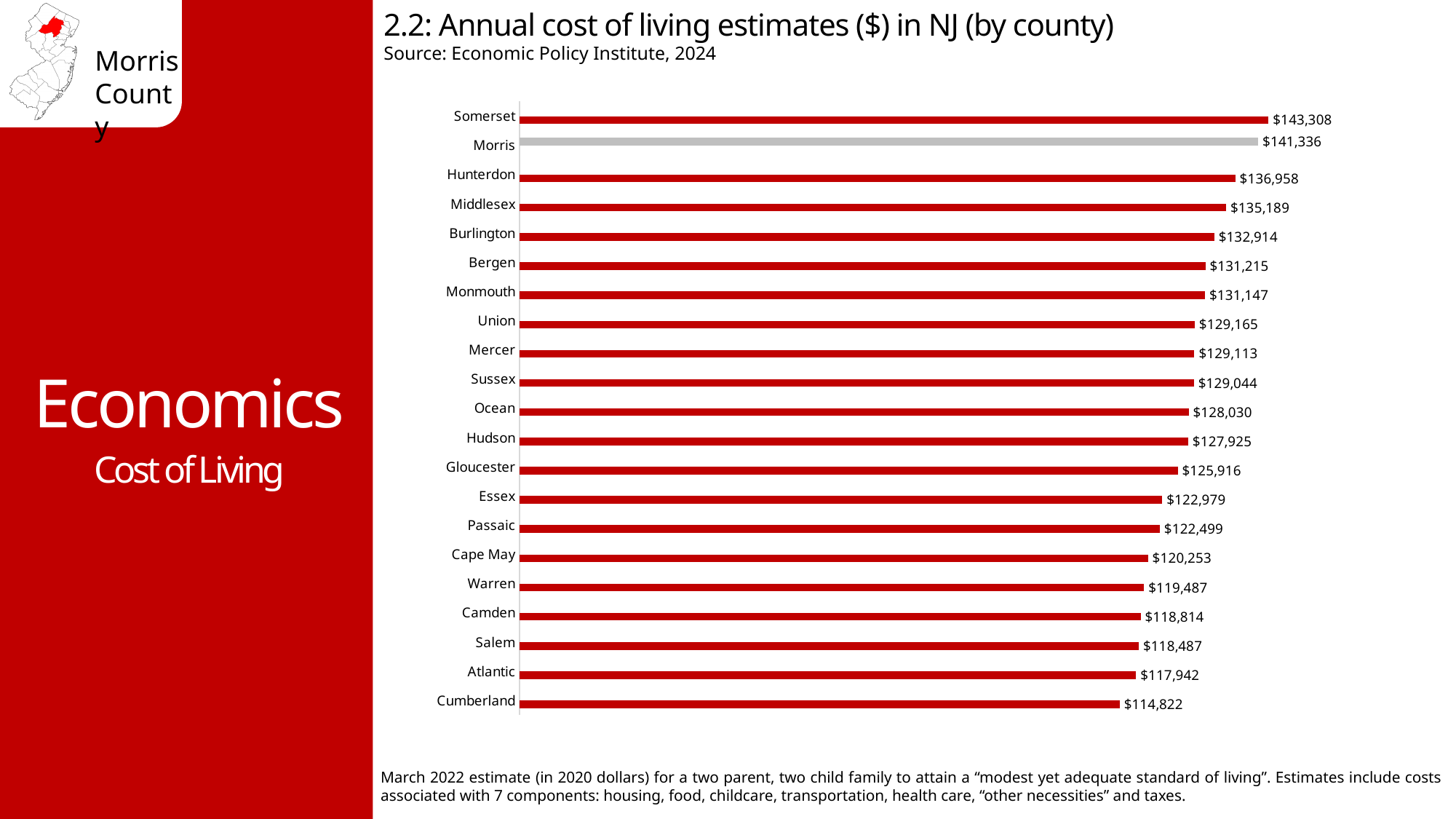
What is the annual cost of living estimate for Cumberland county? $114,822 Which county has the lowest annual cost of living estimate? Cumberland What is the annual cost of living estimate for Hudson county? $127,925 How many counties are shown in the chart? 21 What is the difference between the cost of living estimates for Morris and Hunterdon counties? $4,378 Which county has the highest annual cost of living estimate? Somerset Which county has a higher cost of living estimate, Essex or Middlesex? Middlesex What is the annual cost of living estimate for Somerset county? $143,308 What is the difference between the cost of living estimates for Somerset and Morris counties? $1,972 What kind of chart is shown on the slide? Bar chart Which county's bar is coloured grey instead of red? Morris What is the annual cost of living estimate for Morris county? $141,336